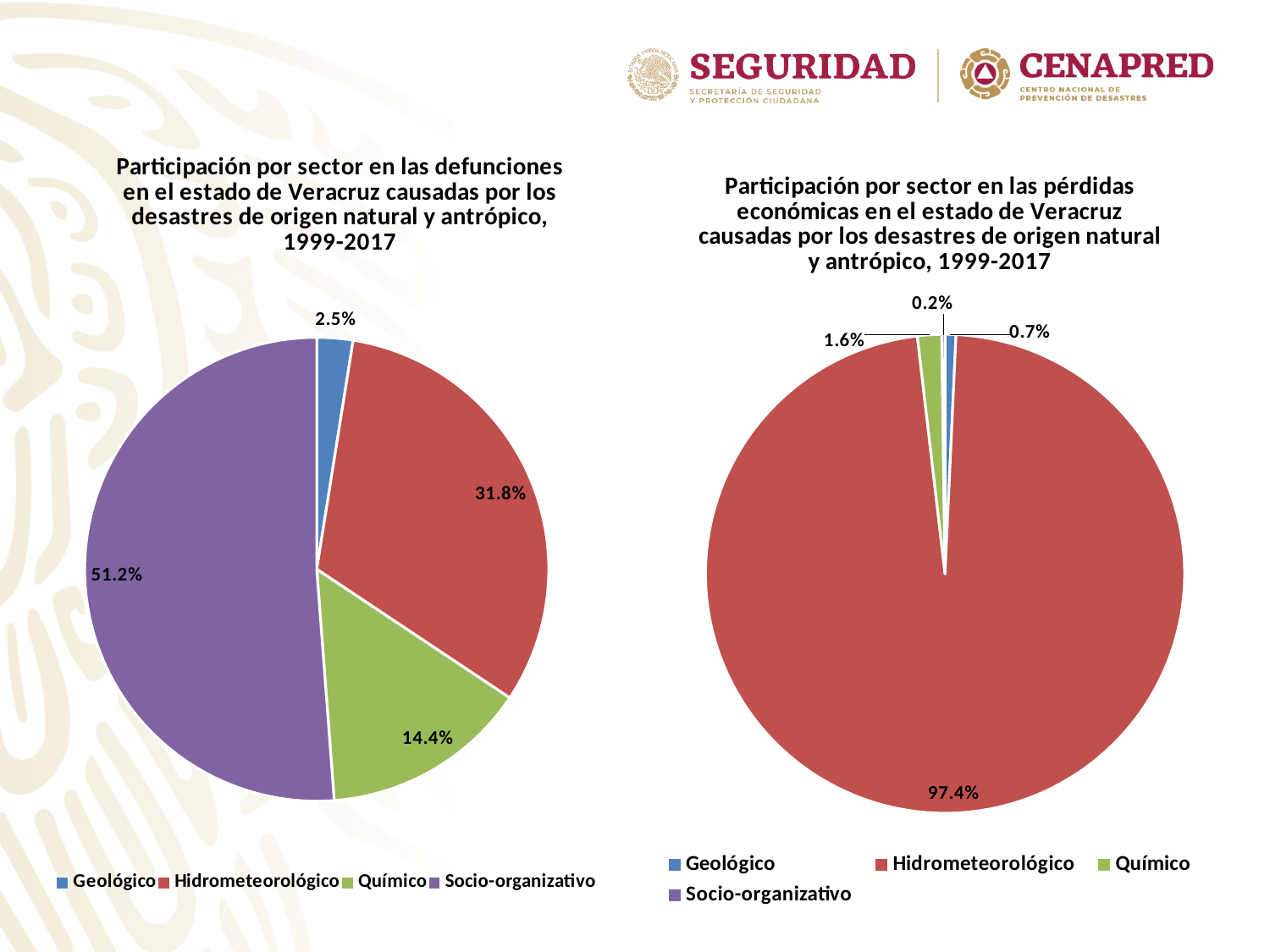
On the left chart (defunciones), what share of deaths is attributed to the Socio-organizativo sector? 51.2% On the left chart (defunciones), which sector has the largest share? Socio-organizativo On the right chart (pérdidas económicas), which is larger, the Geológico share or the Químico share? Químico On the right chart (pérdidas económicas), what share is attributed to the Químico sector? 1.6% How many sectors are shown in the legend of the left chart? 4 On the right chart (pérdidas económicas), what share of economic losses is attributed to the Hidrometeorológico sector? 97.4% On the left chart (defunciones), what share of deaths is attributed to the Hidrometeorológico sector? 31.8% On the left chart, which colour represents the Químico sector? Green On the left chart (defunciones), which sector has the smallest share? Geológico On the right chart (pérdidas económicas), which sector has the smallest share? Socio-organizativo On the left chart (defunciones), what is the difference between the Hidrometeorológico and Químico shares? 17.4% What type of chart is used on the right side of the slide? Pie chart